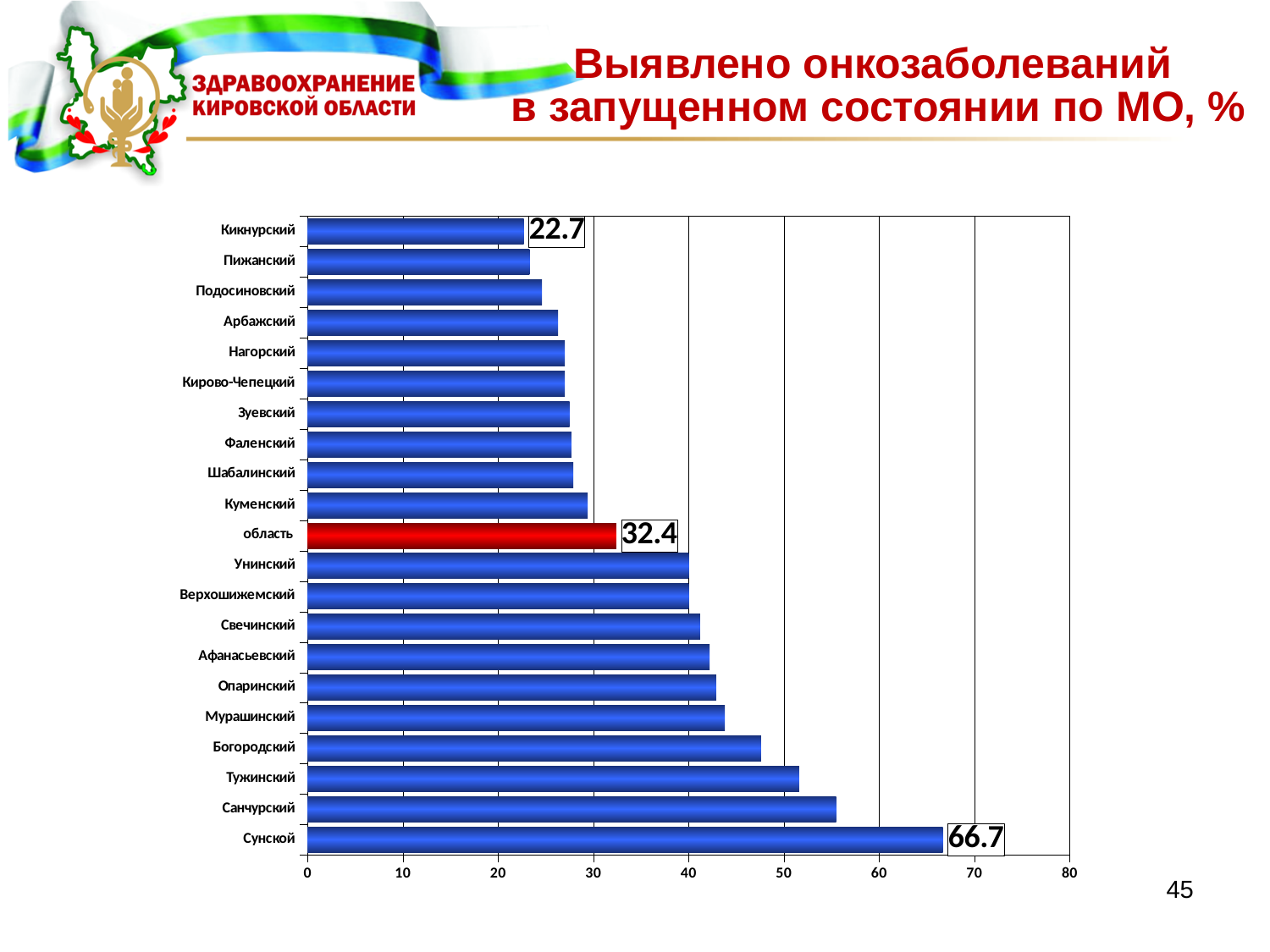
How many categories are shown on the chart? 21 Which category has the lowest value? Кикнурский Is the value for Санчурский greater or less than 50? greater Which category has the highest value? Сунской What is the value for Сунской? 66.7 Is the value for Богородский greater or less than 50? less What is the value for Кикнурский? 22.7 What is the difference between the values for Сунской and Кикнурский? 44 What is the difference between the values for область and Кикнурский? 9.7 Which is larger, the value for Санчурский or the value for Богородский? Санчурский What kind of chart is shown on the slide? bar chart What is the value for область? 32.4